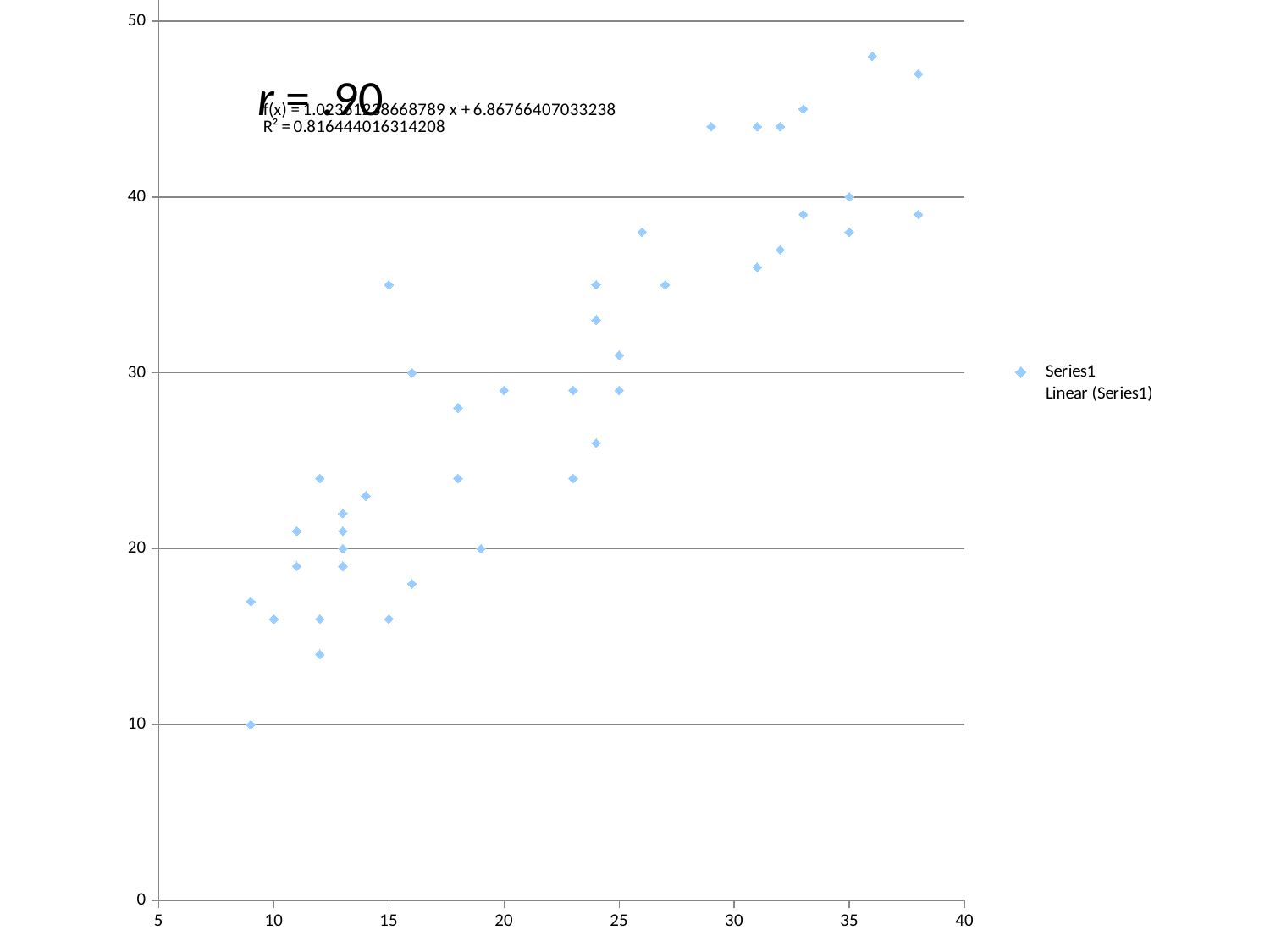
What is the highest value shown on the y axis? 50 Do the y-values generally rise or fall as x increases? rise Is the y-value of the point at x = 26 greater or less than 35? greater Is the y-value of the point at x = 19 greater or less than 25? less What is the y-value of the lowest point on the chart? 10 What R² value is printed on the chart? 0.816444016314208 Is the y-value of the lowest point on the chart greater or less than 15? less What kind of chart is shown on the slide? scatter chart How many entries does the legend list? 2